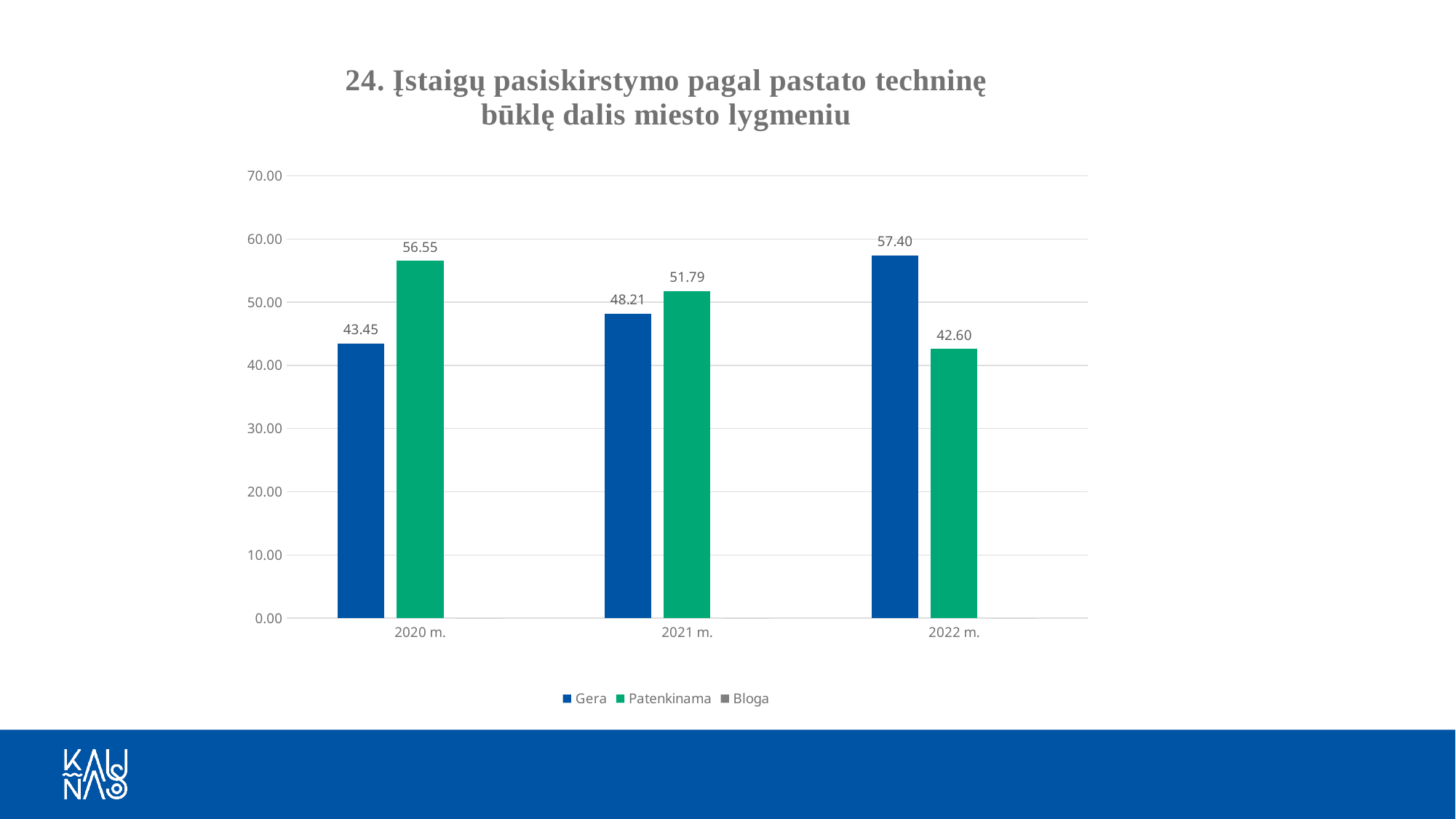
What is the difference between the Patenkinama and Gera values in 2020 m.? 13.10 Which is larger in 2021 m., Gera or Patenkinama? Patenkinama In which year is the Gera value highest? 2022 m. What is the difference between the Gera and Patenkinama values in 2022 m.? 14.80 Does the Gera value rise or fall from 2020 m. to 2022 m.? Rise In which year is the Patenkinama value lowest? 2022 m. What is the value for Gera in 2020 m.? 43.45 How many series does the legend list? 3 How many years are shown on the x axis? 3 What kind of chart is shown on the slide? Bar chart What is the value for Patenkinama in 2021 m.? 51.79 What is the value for Patenkinama in 2022 m.? 42.60